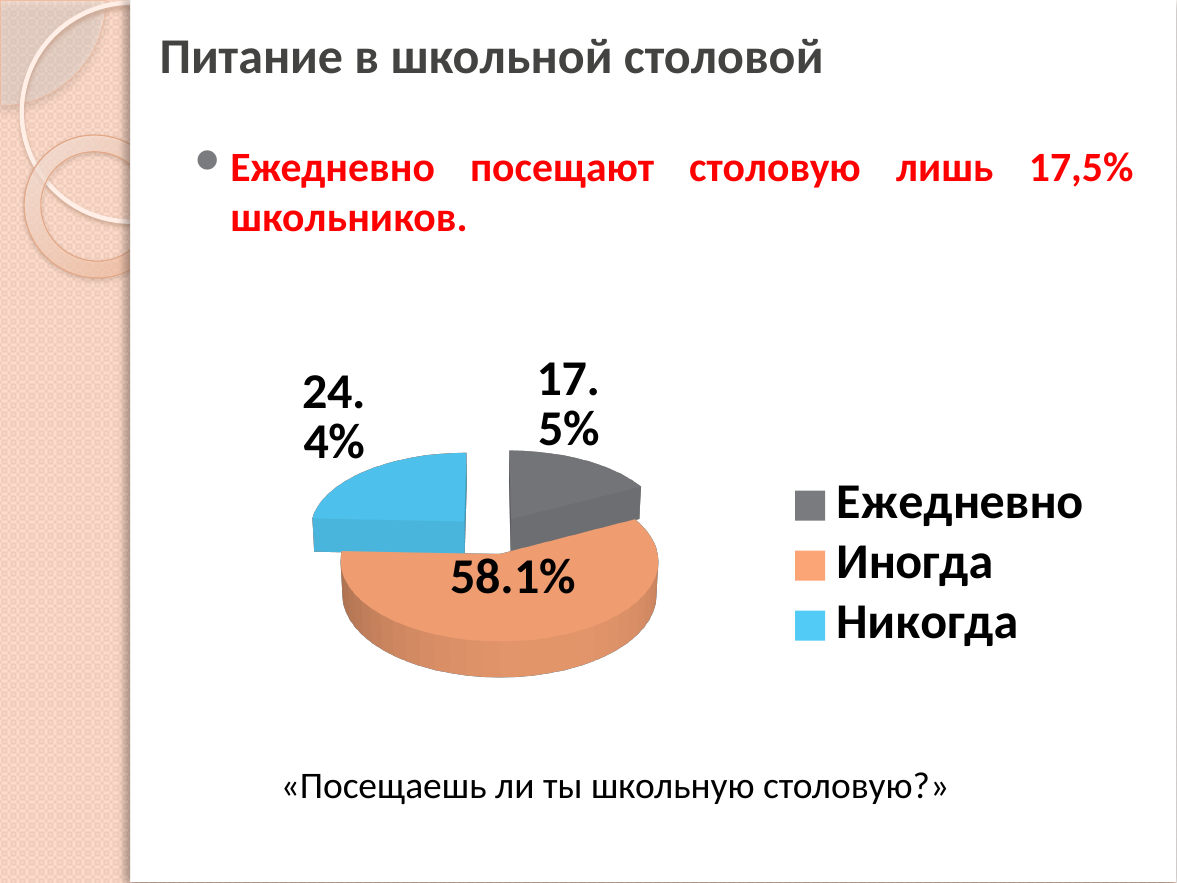
Which slice is larger, "Никогда" or "Ежедневно"? Никогда Which category has the largest slice of the pie? Иногда What is the difference in percentage points between the "Иногда" and "Никогда" slices? 33.7 What share of the pie does the "Никогда" slice represent? 24.4% What share of the pie does the "Ежедневно" slice represent? 17.5% How many entries does the legend list? 3 What share of the pie does the "Иногда" slice represent? 58.1% Which category has the smallest slice of the pie? Ежедневно What colour is the "Никогда" slice in the pie chart? blue What is the difference in percentage points between the "Никогда" and "Ежедневно" slices? 6.9 What kind of chart is shown on the slide? pie chart How many slices does the pie chart have? 3